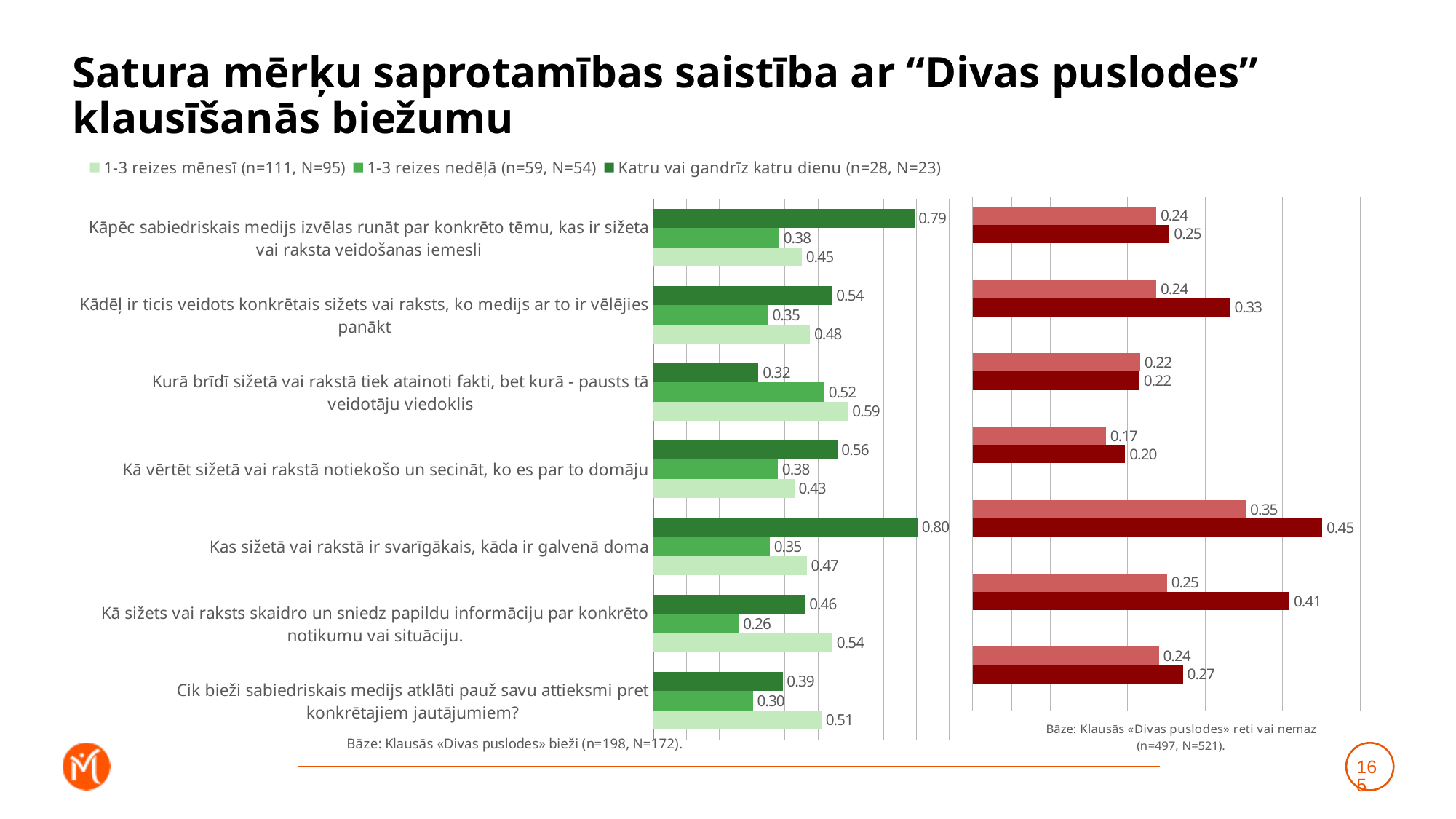
In the left (green) chart, which category has the highest value for the "Katru vai gandrīz katru dienu" series? Kas sižetā vai rakstā ir svarīgākais, kāda ir galvenā doma In the left (green) chart, which category has the lowest value for the "Katru vai gandrīz katru dienu" series? Kurā brīdī sižetā vai rakstā tiek atainoti fakti, bet kurā - pausts tā veidotāju viedoklis In the left (green) chart, what is the difference between the "Katru vai gandrīz katru dienu" value and the "1-3 reizes nedēļā" value for "Kāpēc sabiedriskais medijs izvēlas runāt par konkrēto tēmu, kas ir sižeta vai raksta veidošanas iemesli"? 0.41 In the left (green) chart, for "Cik bieži sabiedriskais medijs atklāti pauž savu attieksmi pret konkrētajiem jautājumiem?", which is larger: the "1-3 reizes mēnesī" value or the "Katru vai gandrīz katru dienu" value? 1-3 reizes mēnesī In the left (green) chart, what is the value for "1-3 reizes nedēļā" for the category "Kā sižets vai raksts skaidro un sniedz papildu informāciju par konkrēto notikumu vai situāciju."? 0.26 How many categories are shown in the left (green) chart? 7 What kind of chart is the left (green) chart? Bar chart In the left (green) chart, what is the value for "1-3 reizes mēnesī" for the category "Kurā brīdī sižetā vai rakstā tiek atainoti fakti, bet kurā - pausts tā veidotāju viedoklis"? 0.59 In the left (green) chart, what is the value for "Katru vai gandrīz katru dienu" for the category "Kas sižetā vai rakstā ir svarīgākais, kāda ir galvenā doma"? 0.80 In the right (red) chart, what is the highest value shown among the darker red bars? 0.45 How many series does the legend of the left (green) chart list? 3 In the right (red) chart, what is the value of the lighter red bar for the category "Kā vērtēt sižetā vai rakstā notiekošo un secināt, ko es par to domāju"? 0.17